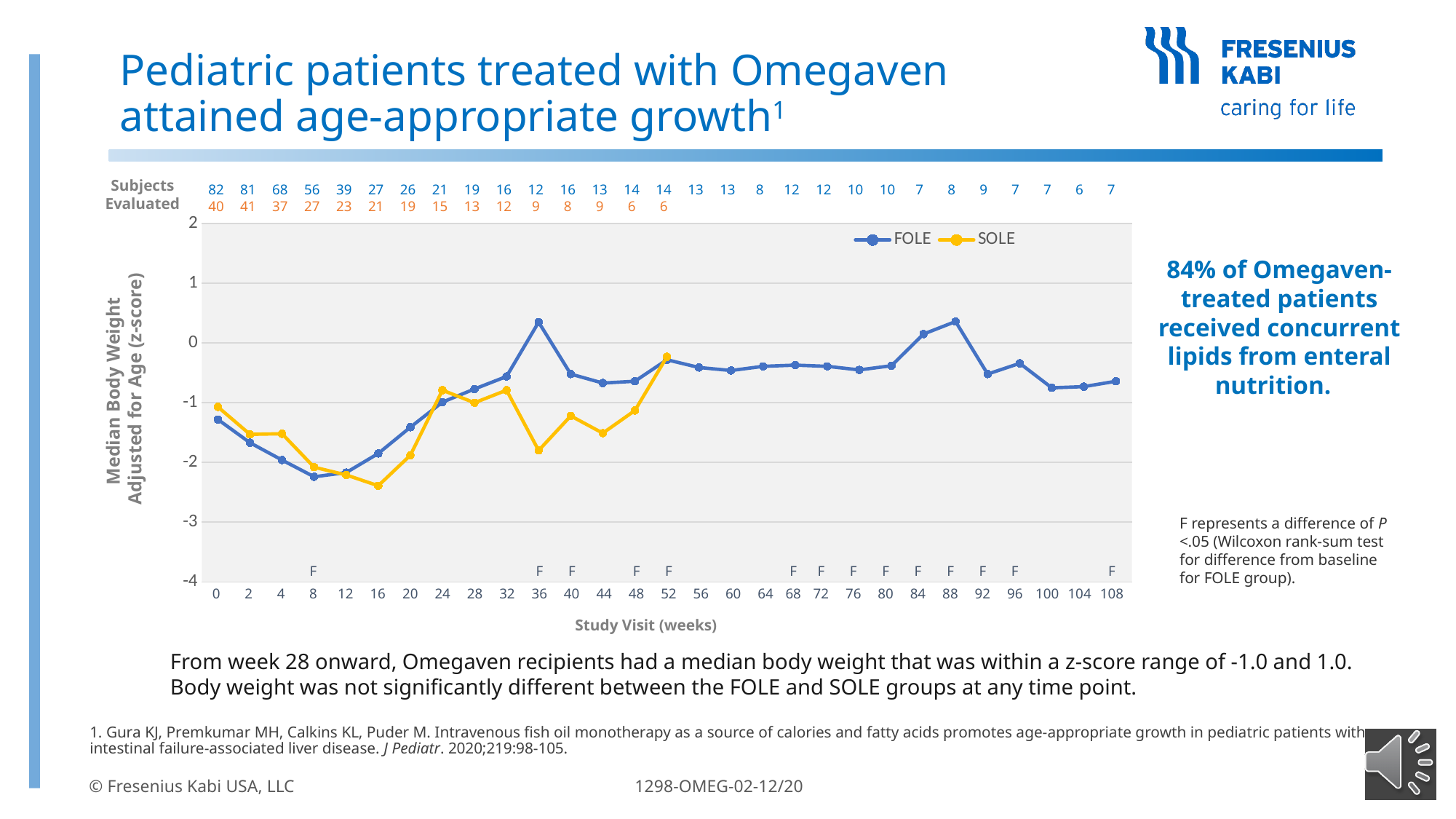
Is the FOLE value at week 8 greater or less than -2? less How many series does the chart legend list? 2 At which study visit week does the SOLE series reach its lowest value? 16 How many study visit time points are shown on the x axis of the chart? 29 Is the SOLE value at week 36 greater or less than -1? less How many FOLE subjects were evaluated at week 0, according to the Subjects Evaluated row? 82 Does the FOLE series rise or fall between week 0 and week 8? fall Is the FOLE value at week 36 greater or less than 0? greater What are the two series named in the chart legend? FOLE and SOLE At week 36, which series has the higher median body weight z-score, FOLE or SOLE? FOLE What kind of chart is shown on the slide? line chart